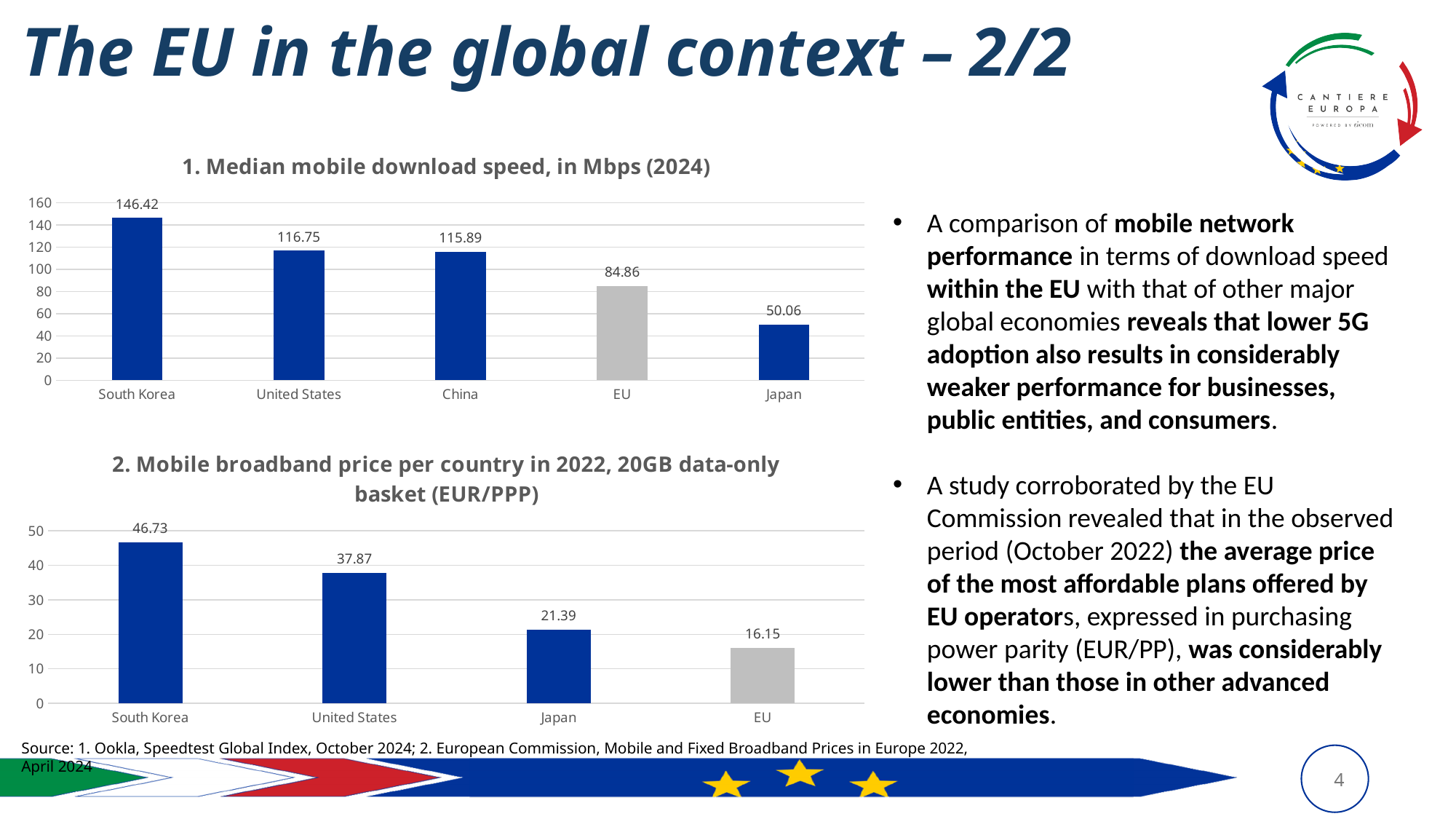
In the chart '1. Median mobile download speed, in Mbps (2024)', what is the difference between South Korea and the EU? 61.56 In the chart '1. Median mobile download speed, in Mbps (2024)', what is the value for South Korea? 146.42 In the chart '2. Mobile broadband price per country in 2022, 20GB data-only basket (EUR/PPP)', which is larger, Japan or the EU? Japan In the chart '2. Mobile broadband price per country in 2022, 20GB data-only basket (EUR/PPP)', do the values rise or fall from left to right? Fall In the chart '1. Median mobile download speed, in Mbps (2024)', what is the value for the EU? 84.86 In the chart '2. Mobile broadband price per country in 2022, 20GB data-only basket (EUR/PPP)', what is the value for the United States? 37.87 In the chart '2. Mobile broadband price per country in 2022, 20GB data-only basket (EUR/PPP)', which country has the highest value? South Korea What kind of chart is the bottom chart on the slide? Bar chart In the chart '1. Median mobile download speed, in Mbps (2024)', is the value for the EU greater or less than 100? less In the chart '2. Mobile broadband price per country in 2022, 20GB data-only basket (EUR/PPP)', what is the difference between South Korea and the EU? 30.58 In the chart '1. Median mobile download speed, in Mbps (2024)', which country has the lowest value? Japan In the chart '1. Median mobile download speed, in Mbps (2024)', how many countries/regions are shown? 5